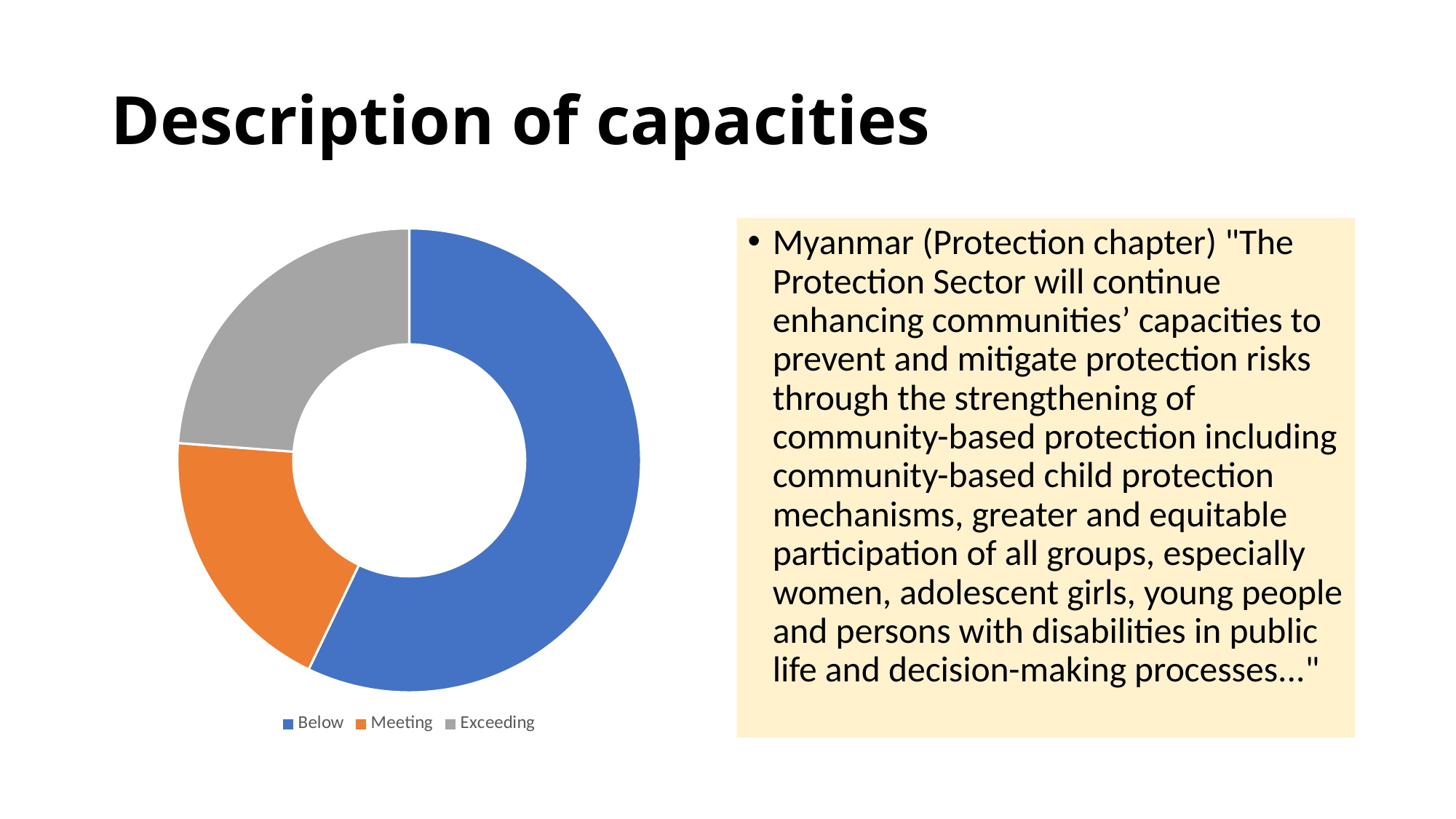
What kind of chart is shown on the slide? Doughnut chart What colour represents the Below category in the doughnut chart? Blue Which is larger in the doughnut chart, Below or Exceeding? Below What are the legend entries of the doughnut chart, in order? Below, Meeting, Exceeding How many categories does the doughnut chart show? 3 Which category takes up the largest share of the doughnut chart? Below Which is larger in the doughnut chart, Below or Meeting? Below How many entries does the legend of the doughnut chart list? 3